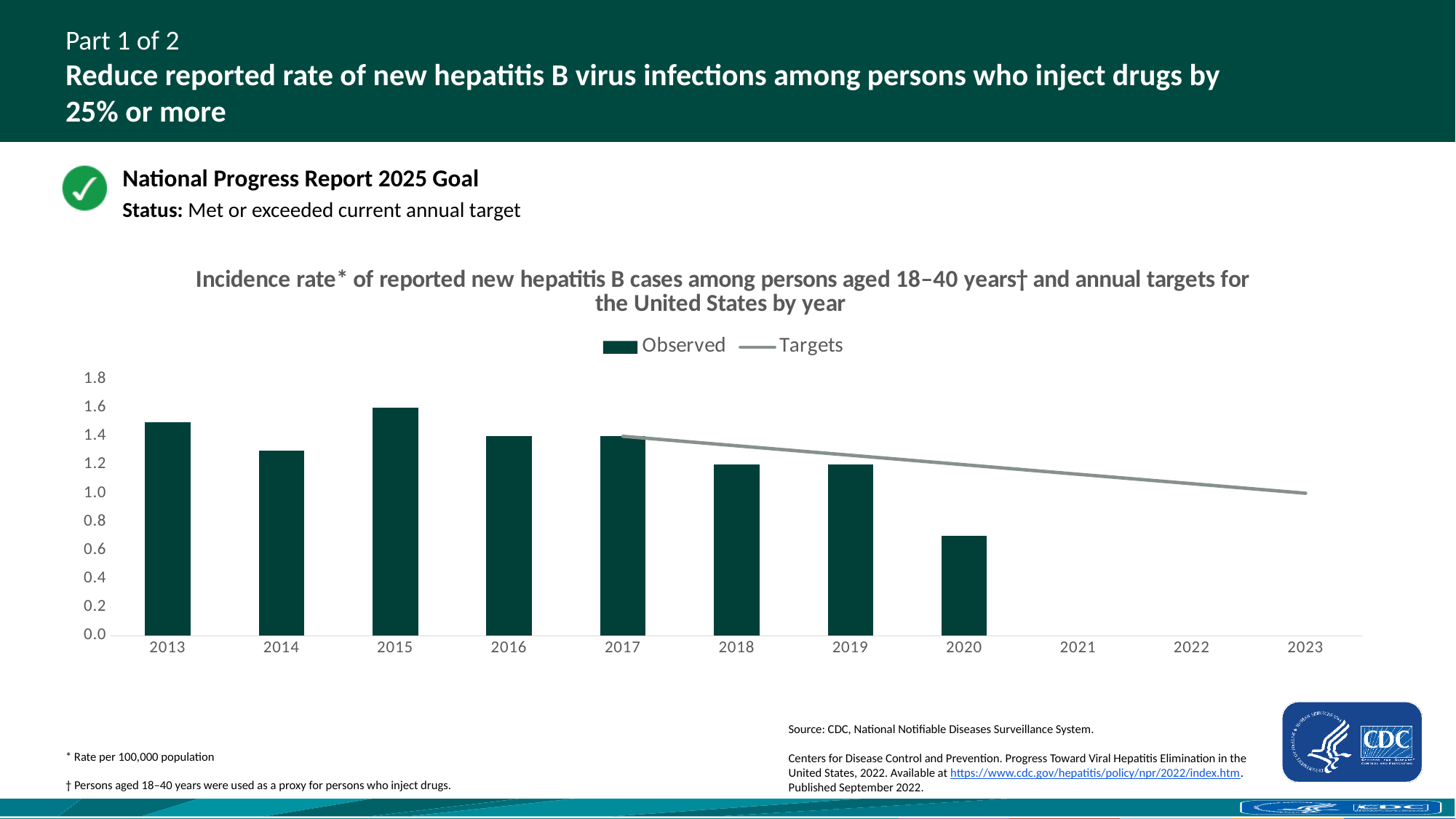
How many series does the chart legend list? 2 How many years have an Observed bar plotted? 8 What are the two series named in the legend? Observed and Targets Is the Observed value for 2020 greater or less than 0.8? less Which year has the highest Observed incidence rate? 2015 Does the Targets line rise or fall from 2017 to 2023? fall Is the Observed value for 2015 greater or less than 1.4? greater How many years are labelled on the x axis? 11 Is the Observed value for 2018 greater or less than 1.4? less Which year has the larger Observed value, 2013 or 2014? 2013 Which year has the lowest Observed incidence rate? 2020 What kind of chart is shown on the slide? Bar chart with a line